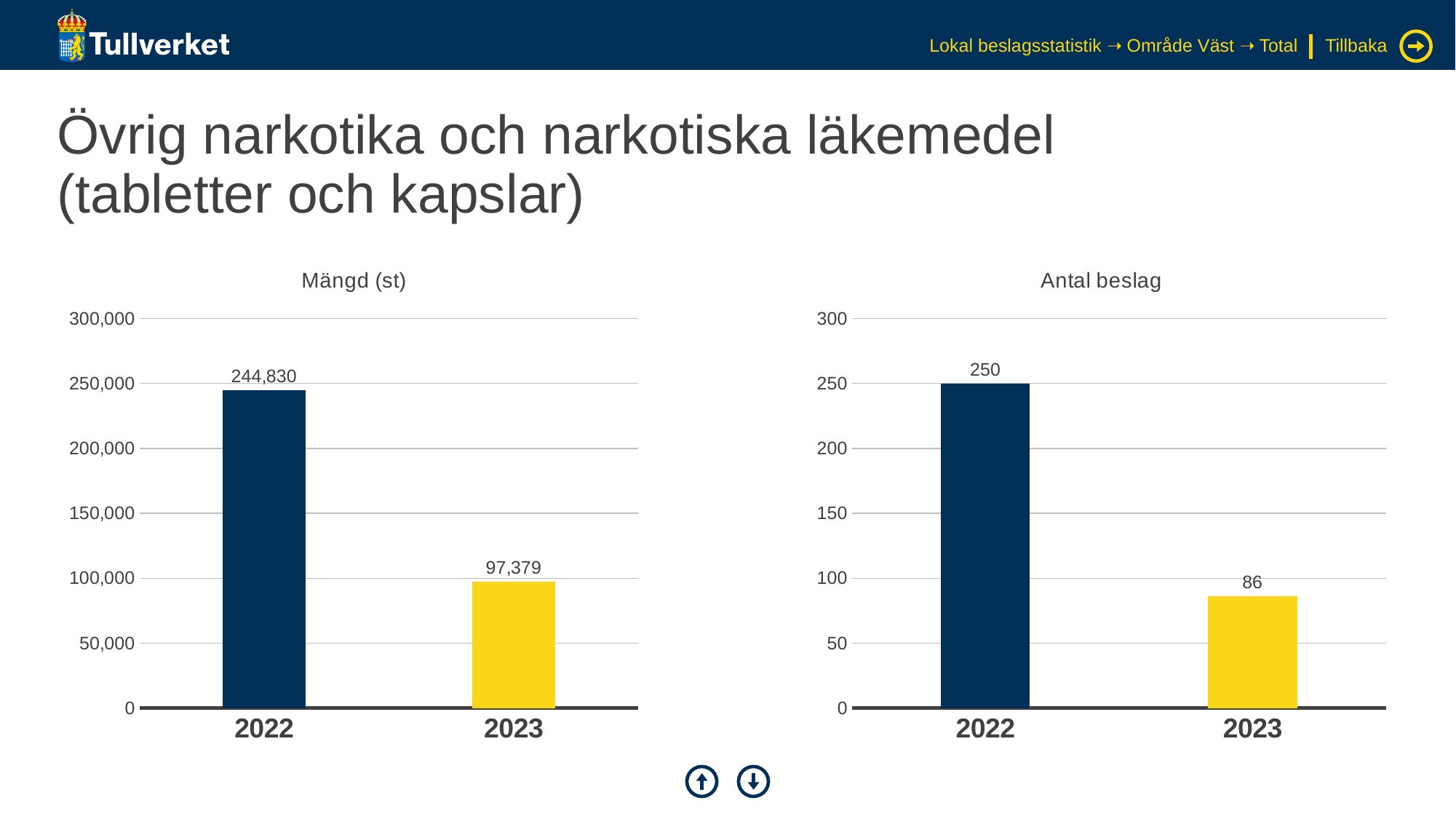
In the 'Mängd (st)' chart, what is the value for 2022? 244,830 In the 'Mängd (st)' chart, which year has the highest value? 2022 In the 'Antal beslag' chart, what is the difference between the 2022 and 2023 values? 164 In the 'Mängd (st)' chart, what is the value for 2023? 97,379 How many categories are shown on the x axis of the 'Mängd (st)' chart? 2 In the 'Mängd (st)' chart, what is the difference between the 2022 and 2023 values? 147,451 In the 'Antal beslag' chart, what is the value for 2022? 250 In the 'Antal beslag' chart, which year has the lowest value? 2023 In the 'Antal beslag' chart, is the value for 2023 greater or less than 100? less In the 'Mängd (st)' chart, do the values rise or fall from 2022 to 2023? fall What kind of chart is the 'Antal beslag' chart? bar chart In the 'Antal beslag' chart, what is the value for 2023? 86